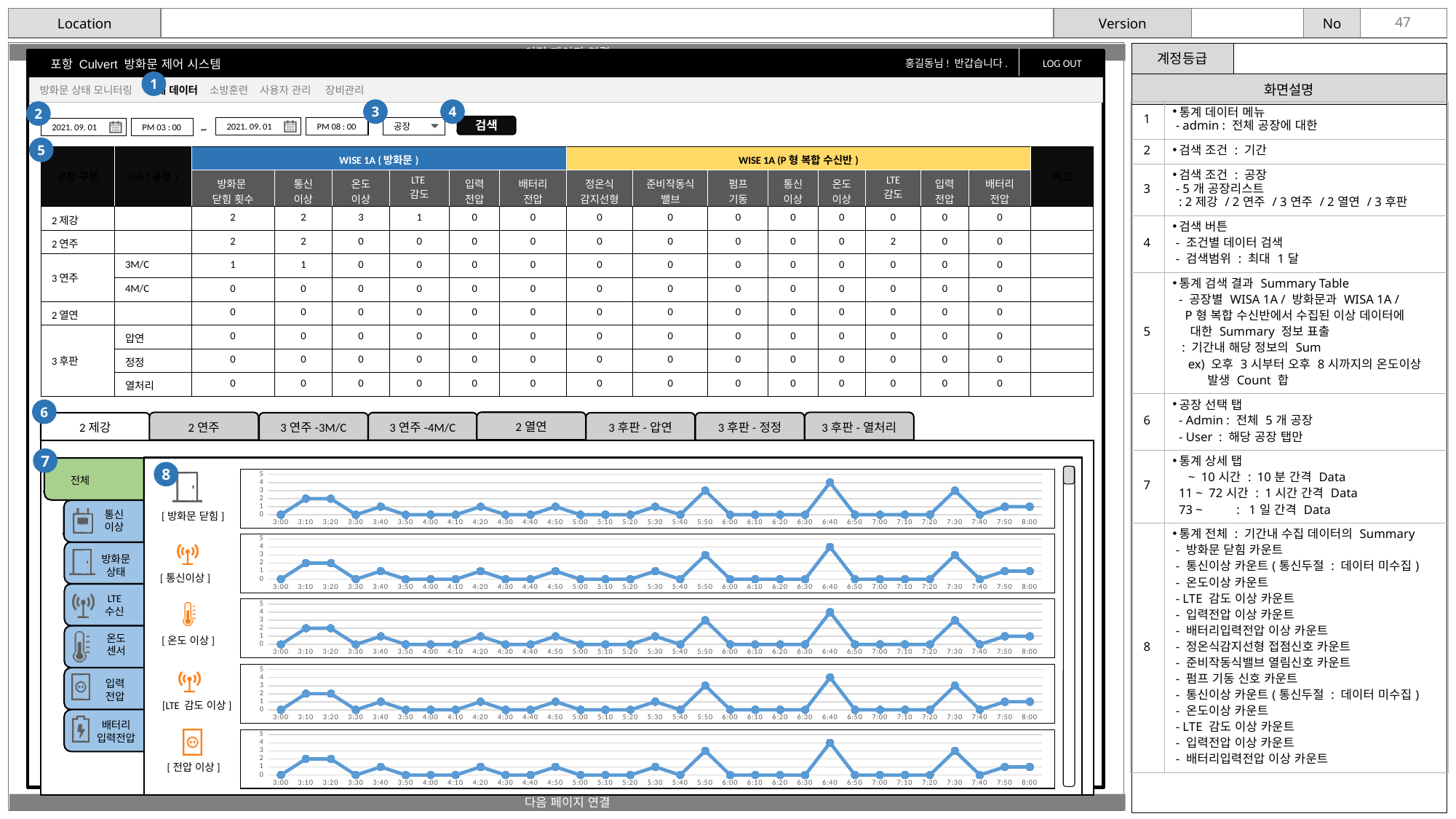
In the [방화문 닫힘] chart, which is larger, the value at 3:10 or the value at 4:00? 3:10 In the [온도 이상] chart, is the value at 3:00 greater or less than 1? less What kind of chart is the top chart labelled [방화문 닫힘]? line chart In the [전압 이상] chart, which is larger, the value at 6:40 or the value at 7:00? 6:40 What is the highest tick value shown on the y axis of the [통신이상] chart? 5 In the [LTE 감도 이상] chart, is the value at 5:50 greater or less than 2? greater In the [방화문 닫힘] chart, is the value at 6:40 greater or less than 3? greater In the [방화문 닫힘] chart, at which time does the line reach its highest point? 6:40 In the [통신이상] chart, at which time is the highest value plotted? 6:40 How many line charts are shown in the lower panel of the slide? 5 What is the first time label on the x axis of the [전압 이상] chart? 3:00 How many time points are labelled on the x axis of the [방화문 닫힘] chart (from 3:00 to 8:00)? 31